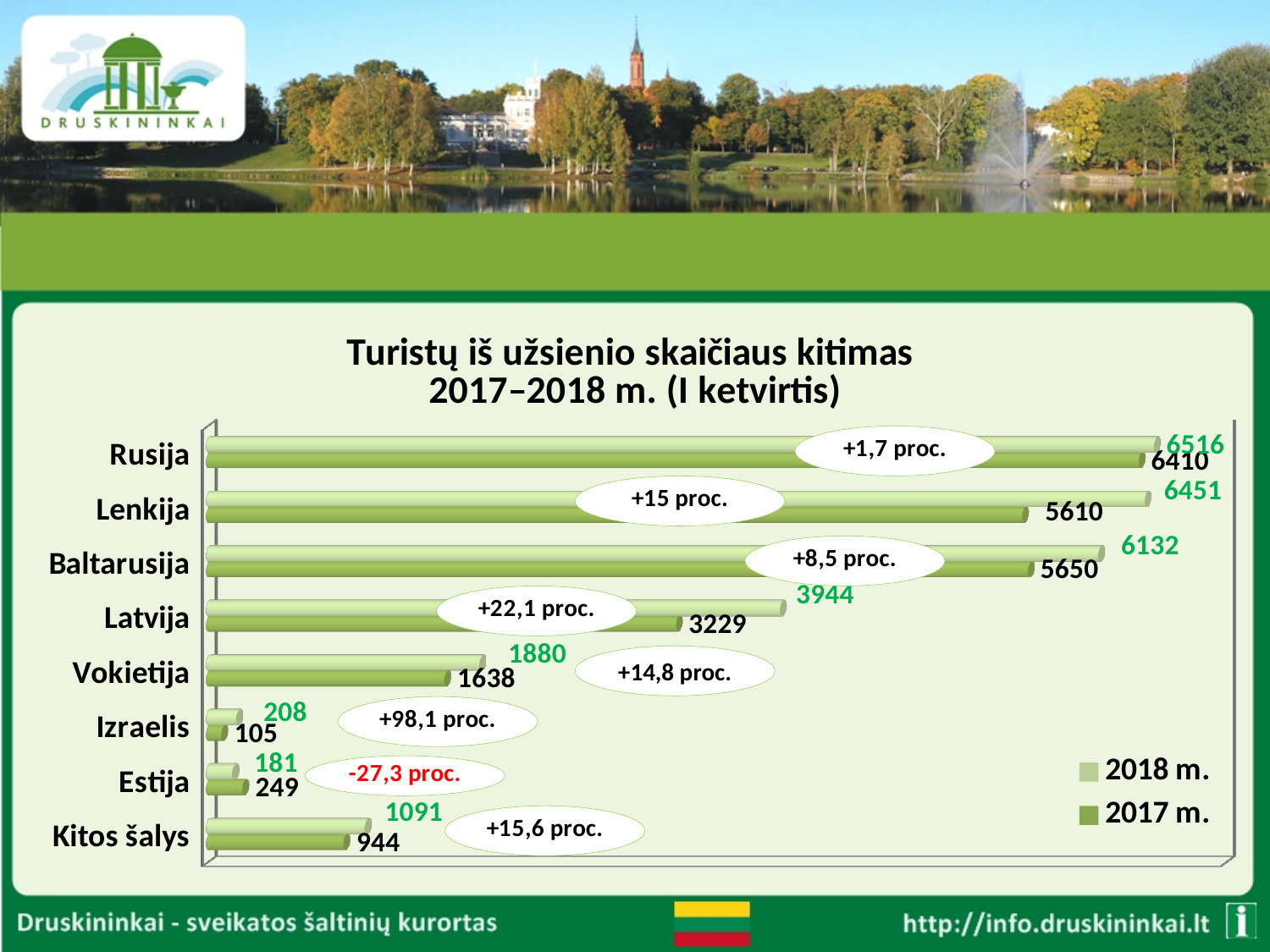
What is the title of the chart? Turistų iš užsienio skaičiaus kitimas 2017–2018 m. (I ketvirtis) What is the difference between the 2018 m. and 2017 m. values for Vokietija? 242 Which category has the lowest 2017 m. value? Izraelis What is the 2017 m. value for Latvija? 3229 Which is larger for Estija: the 2018 m. value or the 2017 m. value? 2017 m. Which category has the highest 2018 m. value? Rusija How many categories are shown on the chart? 8 How many series does the legend list? 2 What kind of chart is shown on the slide? Bar chart What percentage change is shown for Izraelis? +98,1 proc. What is the 2018 m. value for Lenkija? 6451 What is the 2018 m. value for Izraelis? 208